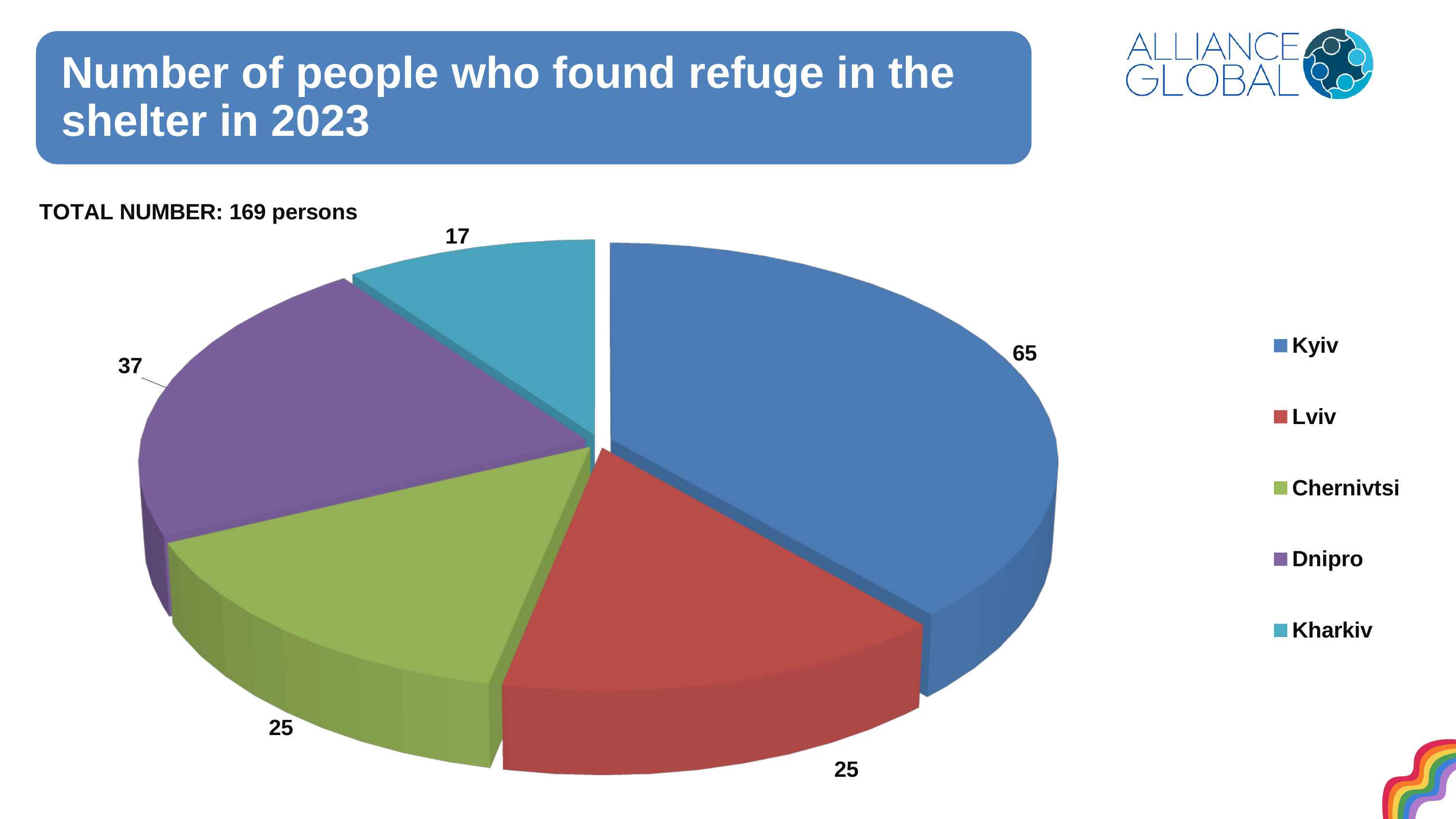
What is the value shown for Lviv? 25 What total number of persons is stated on the slide? 169 persons How many cities are listed in the legend? 5 What type of chart is shown on the slide? Pie chart What is the value shown for Dnipro? 37 How many people found refuge in the shelter from Kyiv? 65 Which is larger, the value for Dnipro or the value for Chernivtsi? Dnipro What is the value shown for Kharkiv? 17 Which city has the smallest slice of the pie? Kharkiv What is the difference between the values for Dnipro and Kharkiv? 20 What is the difference between the values for Kyiv and Dnipro? 28 Which city has the largest slice of the pie? Kyiv